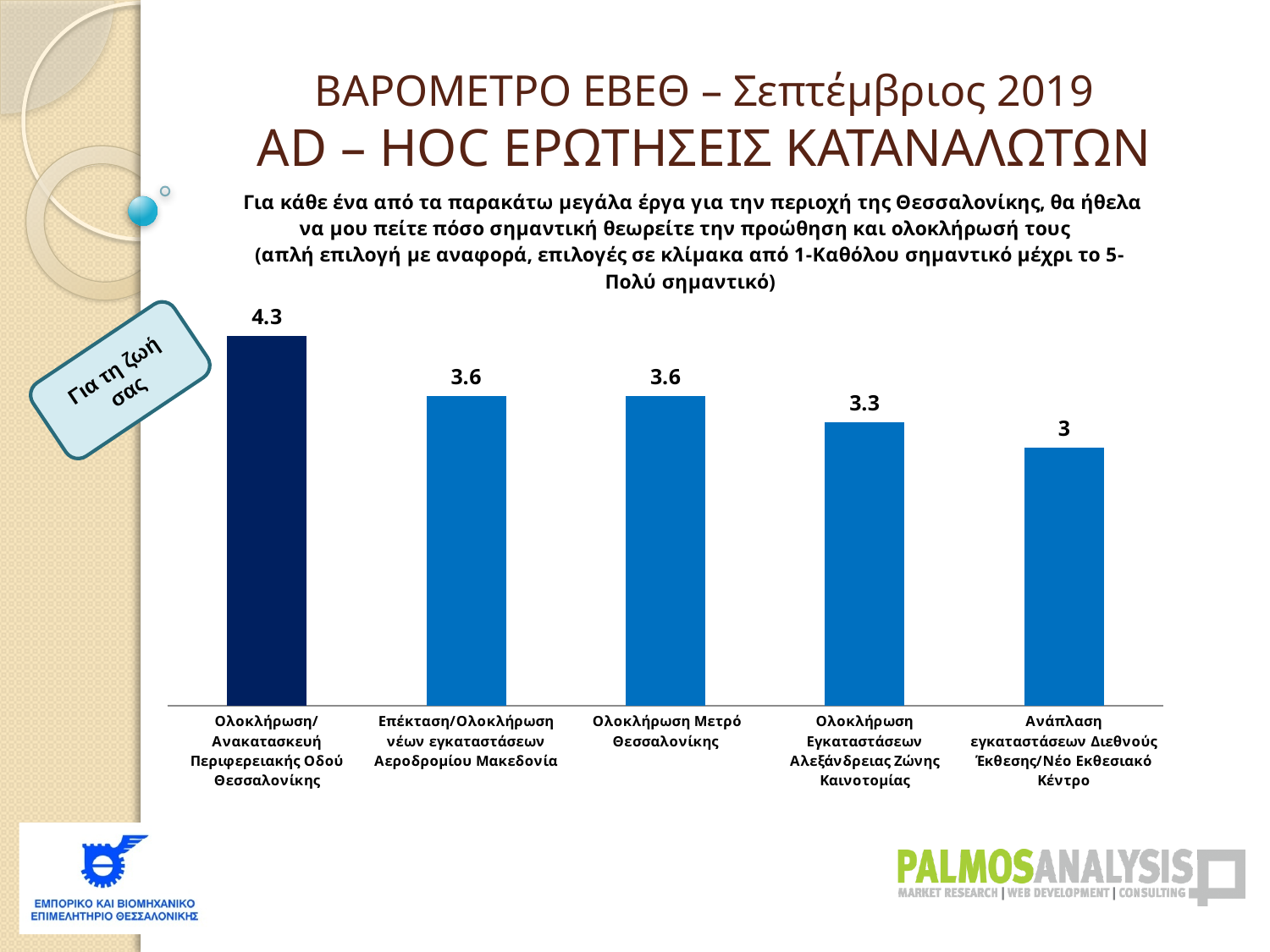
What kind of chart is shown on the slide? Bar chart What is the difference between the value for Ολοκλήρωση/Ανακατασκευή Περιφερειακής Οδού Θεσσαλονίκης and the value for Ανάπλαση εγκαταστάσεων Διεθνούς Έκθεσης/Νέο Εκθεσιακό Κέντρο? 1.3 What is the value for Ολοκλήρωση/Ανακατασκευή Περιφερειακής Οδού Θεσσαλονίκης? 4.3 Which is larger: the value for Ολοκλήρωση Μετρό Θεσσαλονίκης or the value for Ολοκλήρωση Εγκαταστάσεων Αλεξάνδρειας Ζώνης Καινοτομίας? Ολοκλήρωση Μετρό Θεσσαλονίκης Which project has the highest value? Ολοκλήρωση/Ανακατασκευή Περιφερειακής Οδού Θεσσαλονίκης What is the value for Ολοκλήρωση Μετρό Θεσσαλονίκης? 3.6 Which project has the lowest value? Ανάπλαση εγκαταστάσεων Διεθνούς Έκθεσης/Νέο Εκθεσιακό Κέντρο What is the value for Ανάπλαση εγκαταστάσεων Διεθνούς Έκθεσης/Νέο Εκθεσιακό Κέντρο? 3 How many projects are shown in the chart? 5 Which bar is shown in a darker colour than the others? Ολοκλήρωση/Ανακατασκευή Περιφερειακής Οδού Θεσσαλονίκης What is the value for Ολοκλήρωση Εγκαταστάσεων Αλεξάνδρειας Ζώνης Καινοτομίας? 3.3 What is the difference between the value for Επέκταση/Ολοκλήρωση νέων εγκαταστάσεων Αεροδρομίου Μακεδονία and the value for Ολοκλήρωση Εγκαταστάσεων Αλεξάνδρειας Ζώνης Καινοτομίας? 0.3